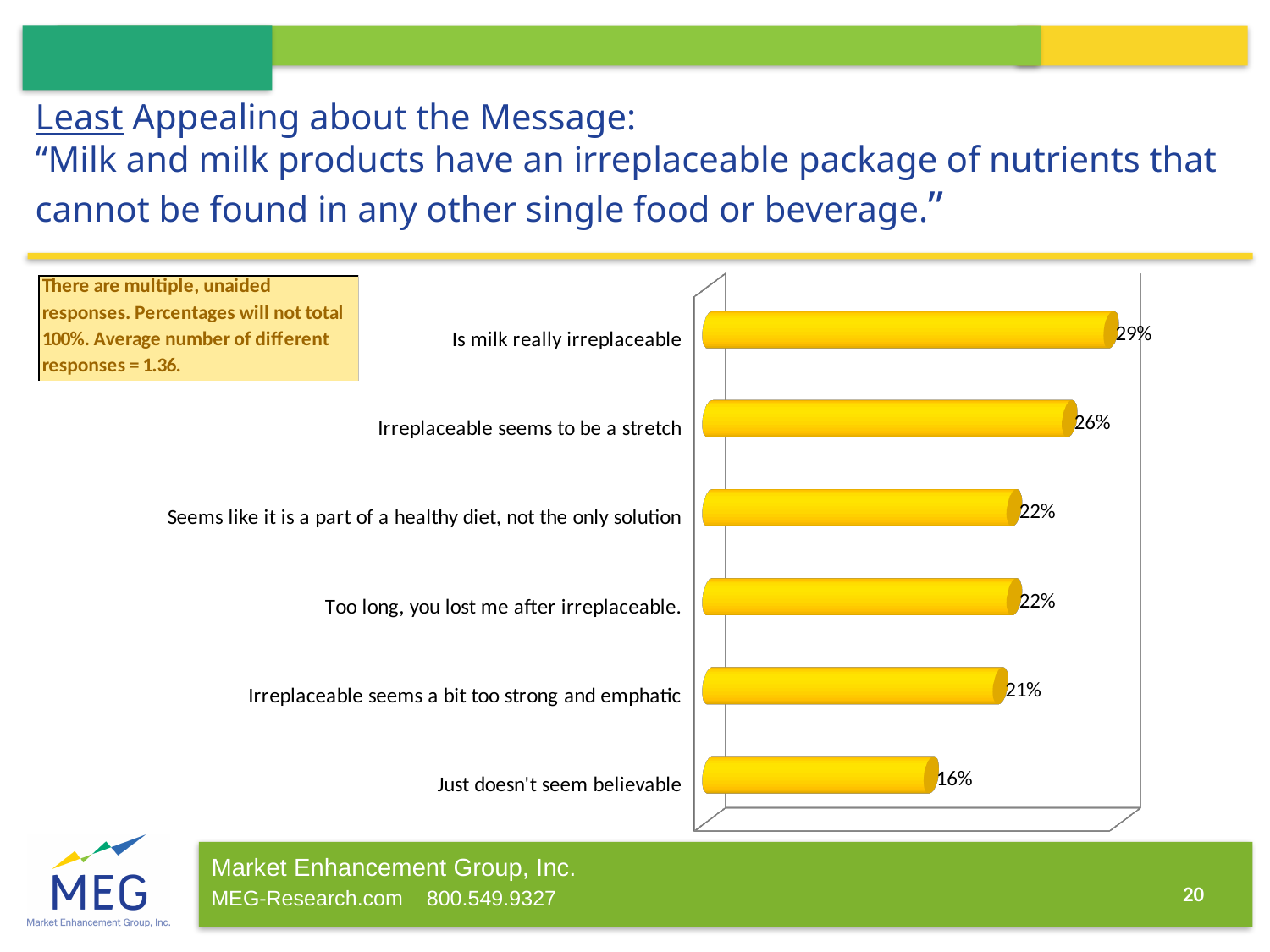
Which two responses share the same value of 22%? Seems like it is a part of a healthy diet, not the only solution; Too long, you lost me after irreplaceable. What is the value for "Irreplaceable seems a bit too strong and emphatic"? 21% What is the difference between "Is milk really irreplaceable" and "Irreplaceable seems to be a stretch"? 3% Which is larger: the value for "Irreplaceable seems to be a stretch" or the value for "Irreplaceable seems a bit too strong and emphatic"? Irreplaceable seems to be a stretch What is the difference between "Irreplaceable seems to be a stretch" and "Just doesn't seem believable"? 10% What is the value for "Just doesn't seem believable"? 16% How many response categories are shown in the chart? 6 What percentage of respondents said "Is milk really irreplaceable"? 29% Which response has the highest percentage? Is milk really irreplaceable What kind of chart is shown on the slide? Bar chart Which response has the lowest percentage? Just doesn't seem believable According to the note on the slide, what is the average number of different responses? 1.36